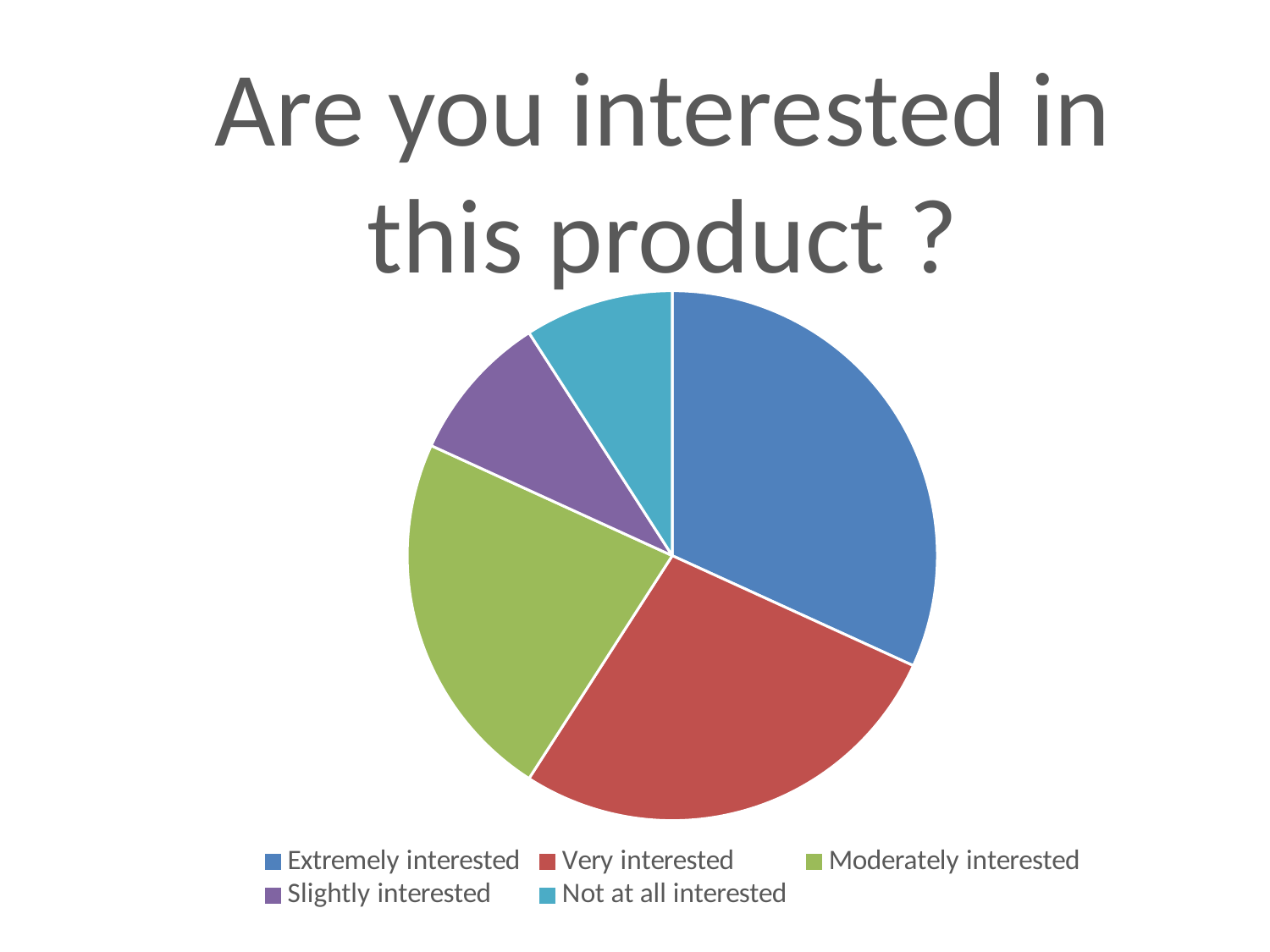
Which colour represents Moderately interested in the pie chart? green What kind of chart is shown on the slide? pie chart Which slice is larger, Very interested or Slightly interested? Very interested How many entries does the legend list? 5 What is the title of the chart? Are you interested in this product ? Which slice is larger, Moderately interested or Not at all interested? Moderately interested Which slice is larger, Very interested or Moderately interested? Very interested Which response category has the largest slice of the pie? Extremely interested How many slices does the pie chart have? 5